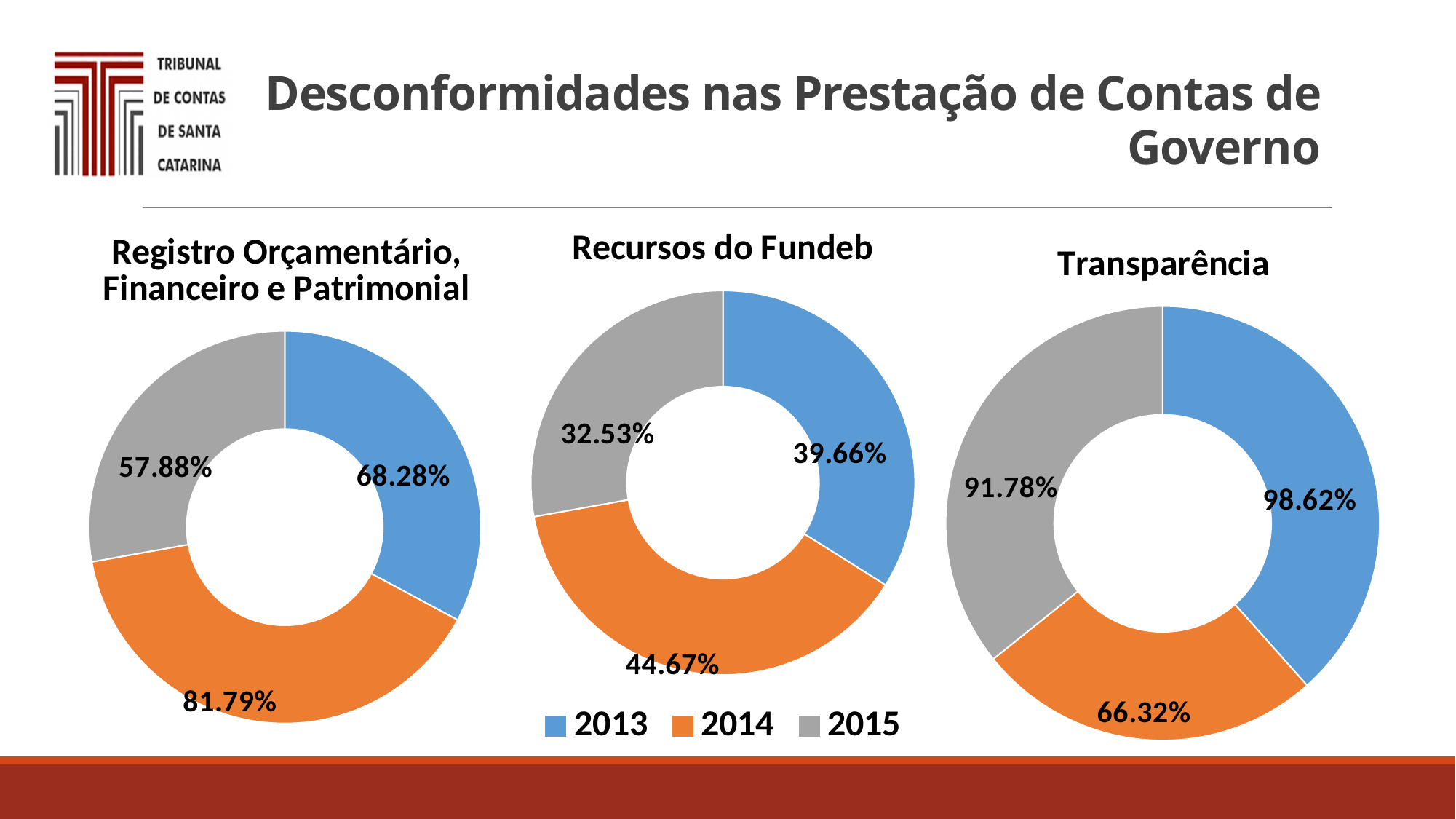
In the 'Transparência' chart, what is the value for 2013? 98.62% In the 'Transparência' chart, what is the value for 2014? 66.32% In the 'Registro Orçamentário, Financeiro e Patrimonial' chart, what is the difference between the 2014 and 2013 values? 13.51% In the 'Registro Orçamentário, Financeiro e Patrimonial' chart, which year has the highest value? 2014 In the 'Transparência' chart, which year has the lowest value? 2014 In the 'Recursos do Fundeb' chart, which year has the lowest value? 2015 How many years does the legend list? 3 In the 'Transparência' chart, what is the difference between the 2013 and 2015 values? 6.84% What kind of chart is the 'Transparência' chart? Doughnut chart In the 'Recursos do Fundeb' chart, what is the value for 2015? 32.53% In the 'Registro Orçamentário, Financeiro e Patrimonial' chart, what is the value for 2014? 81.79% In the 'Recursos do Fundeb' chart, which is larger, the value for 2013 or the value for 2014? 2014